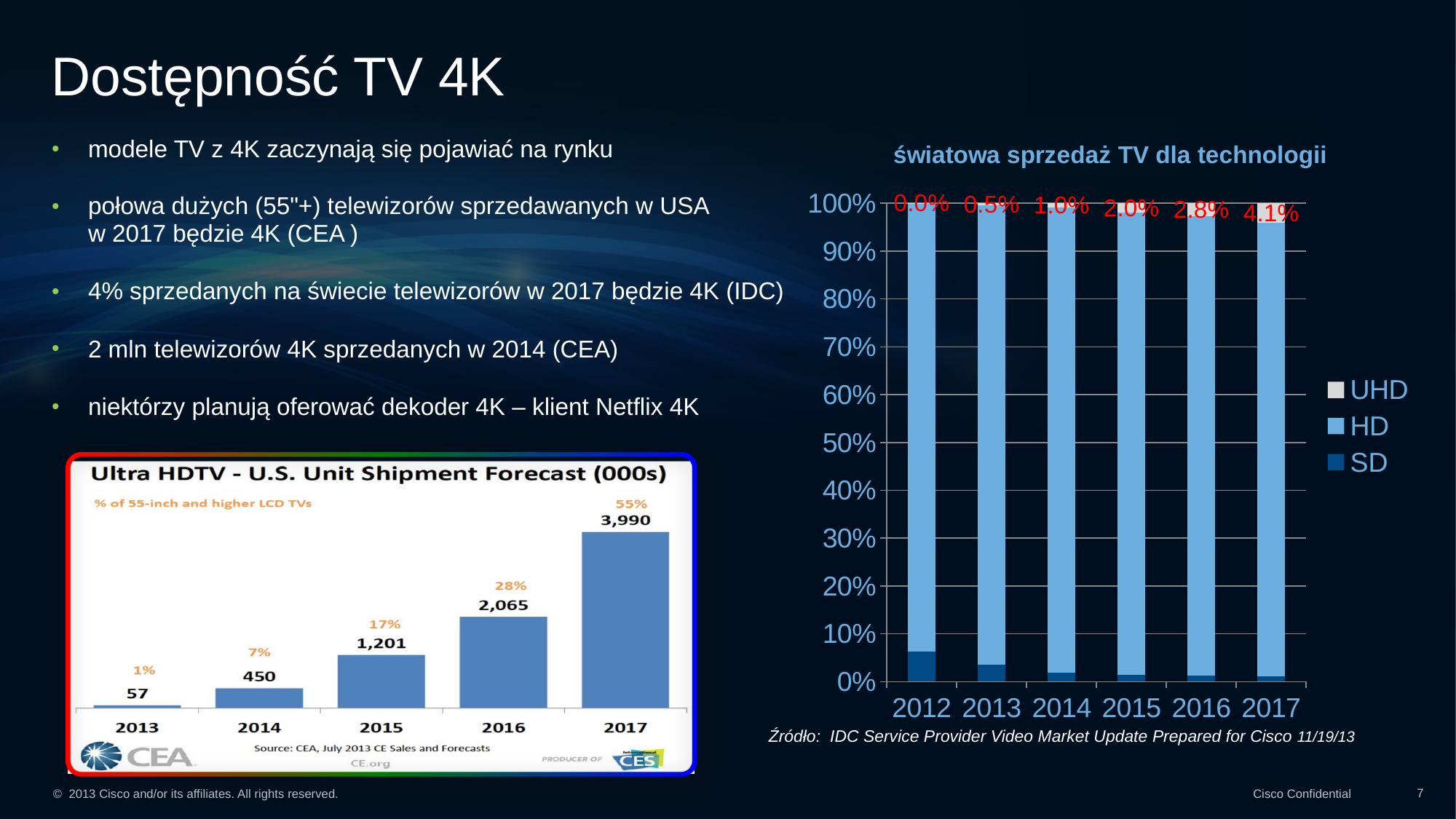
In the 'Ultra HDTV - U.S. Unit Shipment Forecast (000s)' chart, how many years are shown? 5 In the 'światowa sprzedaż TV dla technologii' chart, is the SD share for 2012 greater or less than 10%? less In the 'Ultra HDTV - U.S. Unit Shipment Forecast (000s)' chart, what percentage of 55-inch and higher LCD TVs is shown for 2016? 28% In the 'Ultra HDTV - U.S. Unit Shipment Forecast (000s)' chart, which year has the lowest value? 2013 In the 'Ultra HDTV - U.S. Unit Shipment Forecast (000s)' chart, what is the value for 2015? 1,201 In the 'Ultra HDTV - U.S. Unit Shipment Forecast (000s)' chart, do the values rise or fall from 2013 to 2017? rise In the 'światowa sprzedaż TV dla technologii' chart, how many series does the legend list? 3 In the 'Ultra HDTV - U.S. Unit Shipment Forecast (000s)' chart, what is the difference between the 2017 and 2016 values? 1,925 In the 'Ultra HDTV - U.S. Unit Shipment Forecast (000s)' chart, what is the value for 2017? 3,990 What kind of chart is the 'światowa sprzedaż TV dla technologii' chart? stacked bar chart In the 'światowa sprzedaż TV dla technologii' chart, what is the UHD share for 2017? 4.1% In the 'światowa sprzedaż TV dla technologii' chart, what is the UHD share for 2014? 1.0%